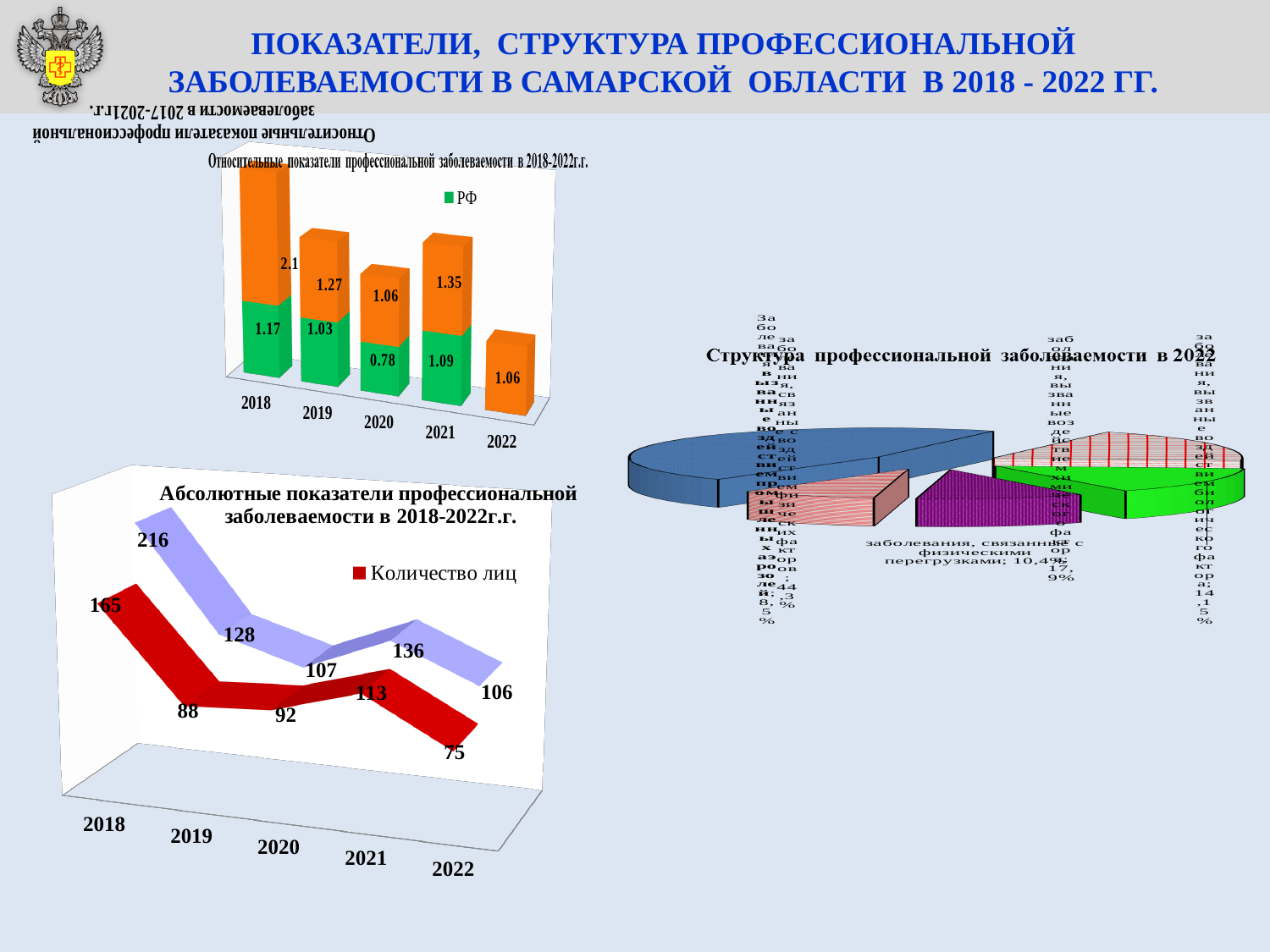
In the chart 'Абсолютные показатели профессиональной заболеваемости в 2018-2022г.г.', which year has the highest value of 'Количество лиц'? 2018 In the chart 'Относительные показатели профессиональной заболеваемости в 2018-2022г.г.', how many years are shown on the x axis? 5 In the chart 'Абсолютные показатели профессиональной заболеваемости в 2018-2022г.г.', what is the value of 'Количество лиц' for 2018? 165 In the chart 'Абсолютные показатели профессиональной заболеваемости в 2018-2022г.г.', what is the difference between the 'Количество лиц' values for 2018 and 2019? 77 In the chart 'Относительные показатели профессиональной заболеваемости в 2018-2022г.г.', what is the value of the РФ series for 2020? 0.78 In the chart 'Относительные показатели профессиональной заболеваемости в 2018-2022г.г.', what is the value of the orange segment for 2018? 2.1 In the pie chart 'Структура профессиональной заболеваемости в 2022', what share is shown for 'заболевания, связанные с физическими перегрузками'? 10,4% What kind of chart is 'Абсолютные показатели профессиональной заболеваемости в 2018-2022г.г.'? Line chart In the chart 'Относительные показатели профессиональной заболеваемости в 2018-2022г.г.', which year has the lowest РФ value? 2020 In the chart 'Относительные показатели профессиональной заболеваемости в 2018-2022г.г.', what is the value of the РФ series for 2018? 1.17 In the chart 'Абсолютные показатели профессиональной заболеваемости в 2018-2022г.г.', what is the value of the blue line for 2021? 136 In the chart 'Абсолютные показатели профессиональной заболеваемости в 2018-2022г.г.', what is the value of 'Количество лиц' for 2022? 75